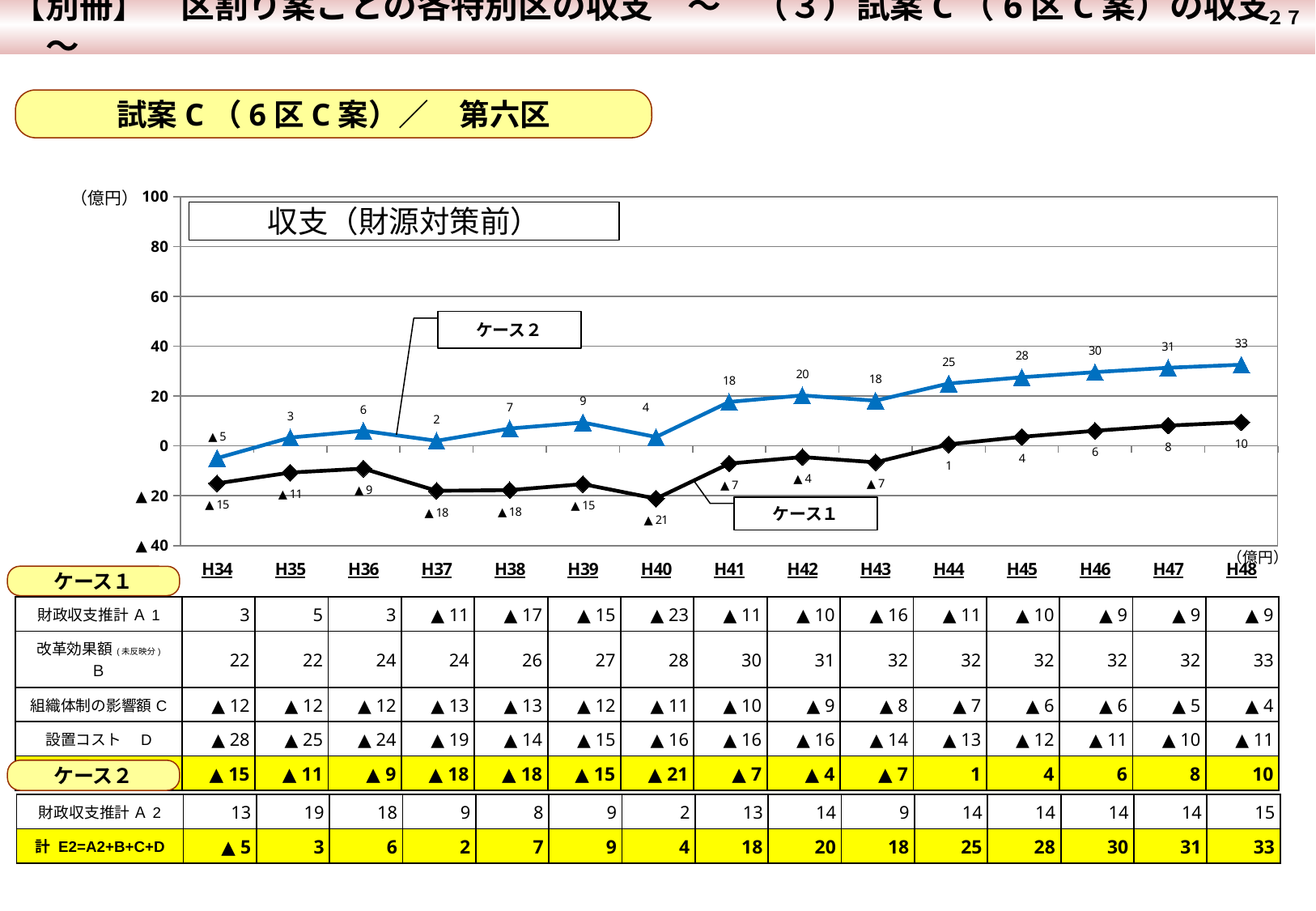
In which year does ケース1 reach its lowest value? H40 What is the title shown inside the chart area? 収支（財源対策前） In which year does ケース2 reach its highest value? H48 Does the ケース2 line rise or fall from H44 to H48? rise At H48, what is the difference between the ケース2 value and the ケース1 value? 23 How many series are plotted in the chart? 2 How many years are plotted along the x axis of the chart? 15 What kind of chart is shown on the slide? line chart What is the value of ケース1 at H40? ▲21 What is the value of ケース2 at H48? 33 Is the value for ケース2 at H45 greater or less than 20? greater At H42, which series has the larger value, ケース1 or ケース2? ケース2